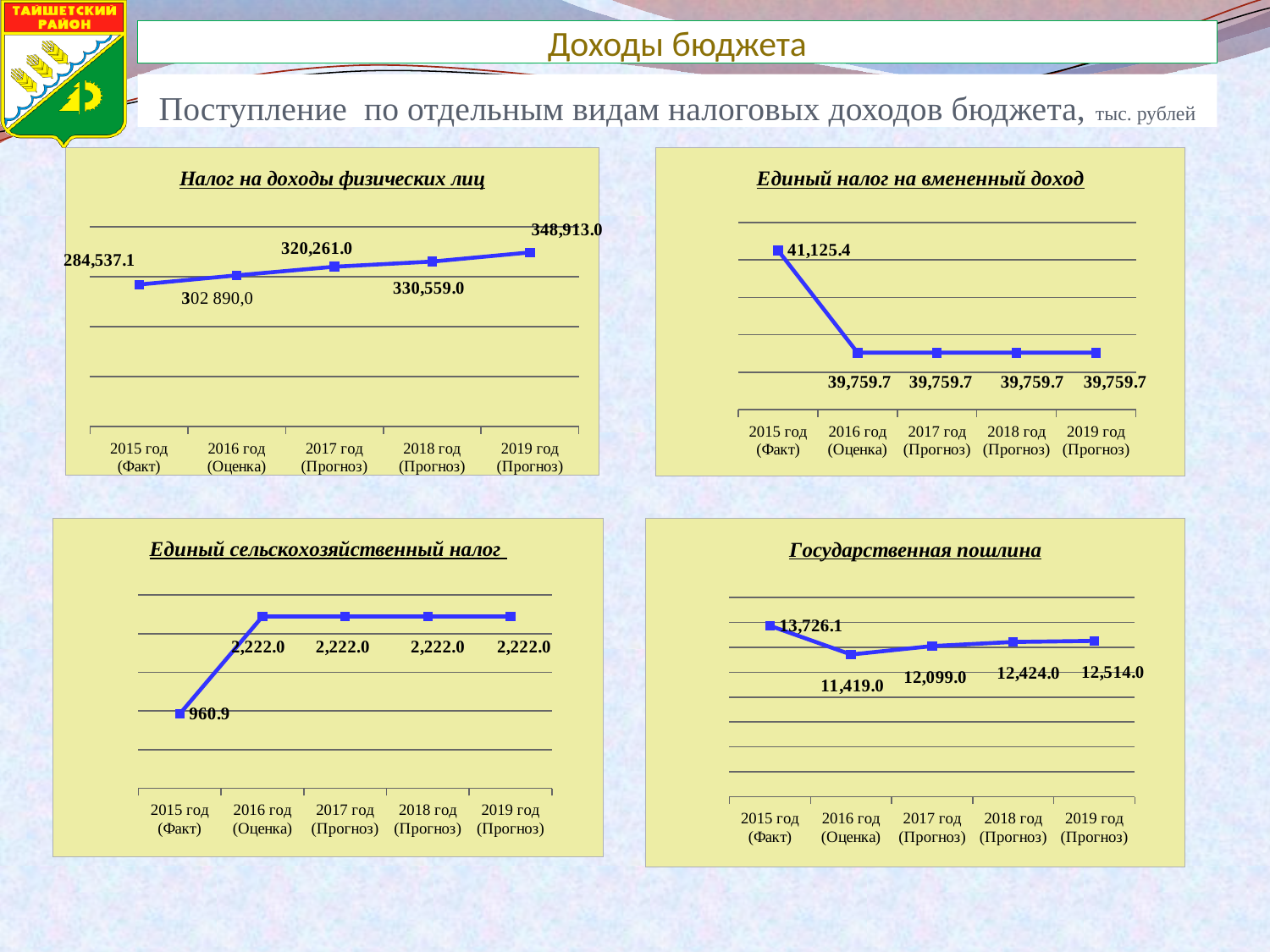
In the chart titled 'Единый сельскохозяйственный налог', what is the value for 2015 год (Факт)? 960.9 In the chart titled 'Налог на доходы физических лиц', what is the value for 2019 год (Прогноз)? 348,913.0 What type of chart is used for 'Государственная пошлина'? line chart In the chart titled 'Налог на доходы физических лиц', do the values rise or fall from 2015 to 2019? rise In the chart titled 'Единый сельскохозяйственный налог', what is the value for 2018 год (Прогноз)? 2,222.0 In the chart titled 'Налог на доходы физических лиц', what is the difference between the 2019 and 2015 values? 64,375.9 In the chart titled 'Государственная пошлина', which year has the lowest value? 2016 год (Оценка) In the chart titled 'Единый налог на вмененный доход', what is the difference between the 2015 and 2016 values? 1,365.7 In the chart titled 'Единый налог на вмененный доход', which year has the highest value? 2015 год (Факт) In the chart titled 'Единый налог на вмененный доход', what is the value for 2015 год (Факт)? 41,125.4 In the chart titled 'Налог на доходы физических лиц', what is the value for 2015 год (Факт)? 284,537.1 In the chart titled 'Государственная пошлина', what is the difference between the 2015 and 2016 values? 2,307.1